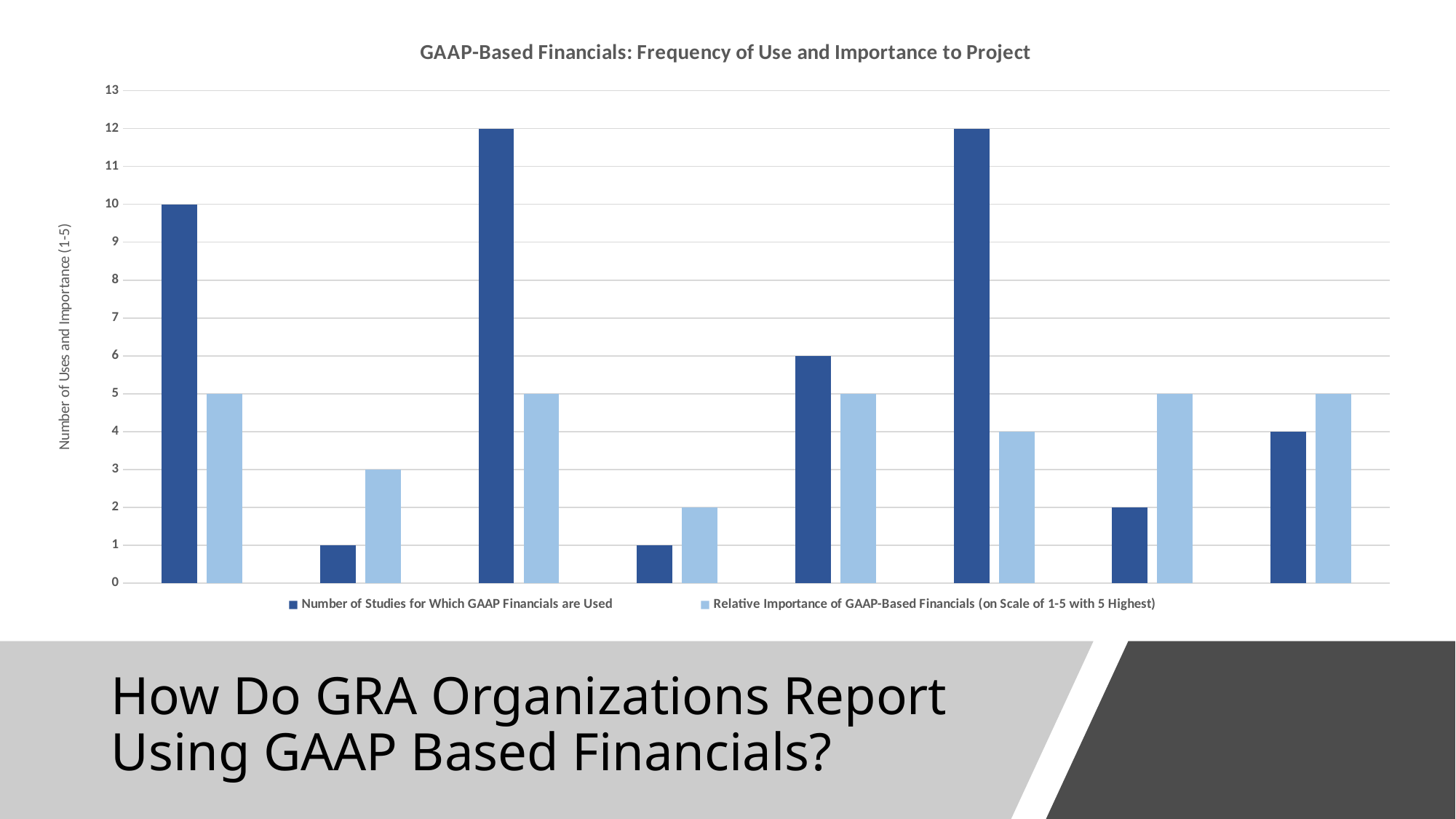
What kind of chart is shown on the slide? Bar chart What is the highest value reached by the Number of Studies for Which GAAP Financials are Used series? 12 Is the dark blue bar in the third group from the left greater or less than 10? greater What is the lowest value reached by the Relative Importance of GAAP-Based Financials series? 2 What is the value of the light blue bar (Relative Importance) in the second group from the left? 3 What is the label on the vertical axis? Number of Uses and Importance (1-5) How many groups of bars are plotted along the x axis? 8 In the fifth group from the left, what is the difference between the dark blue bar and the light blue bar? 1 In the last group on the right, which bar is taller: the dark blue (Number of Studies) or the light blue (Relative Importance)? Light blue (Relative Importance) What is the title of the chart? GAAP-Based Financials: Frequency of Use and Importance to Project How many series does the legend list? 2 What is the value of the dark blue bar (Number of Studies for Which GAAP Financials are Used) in the first group from the left? 10